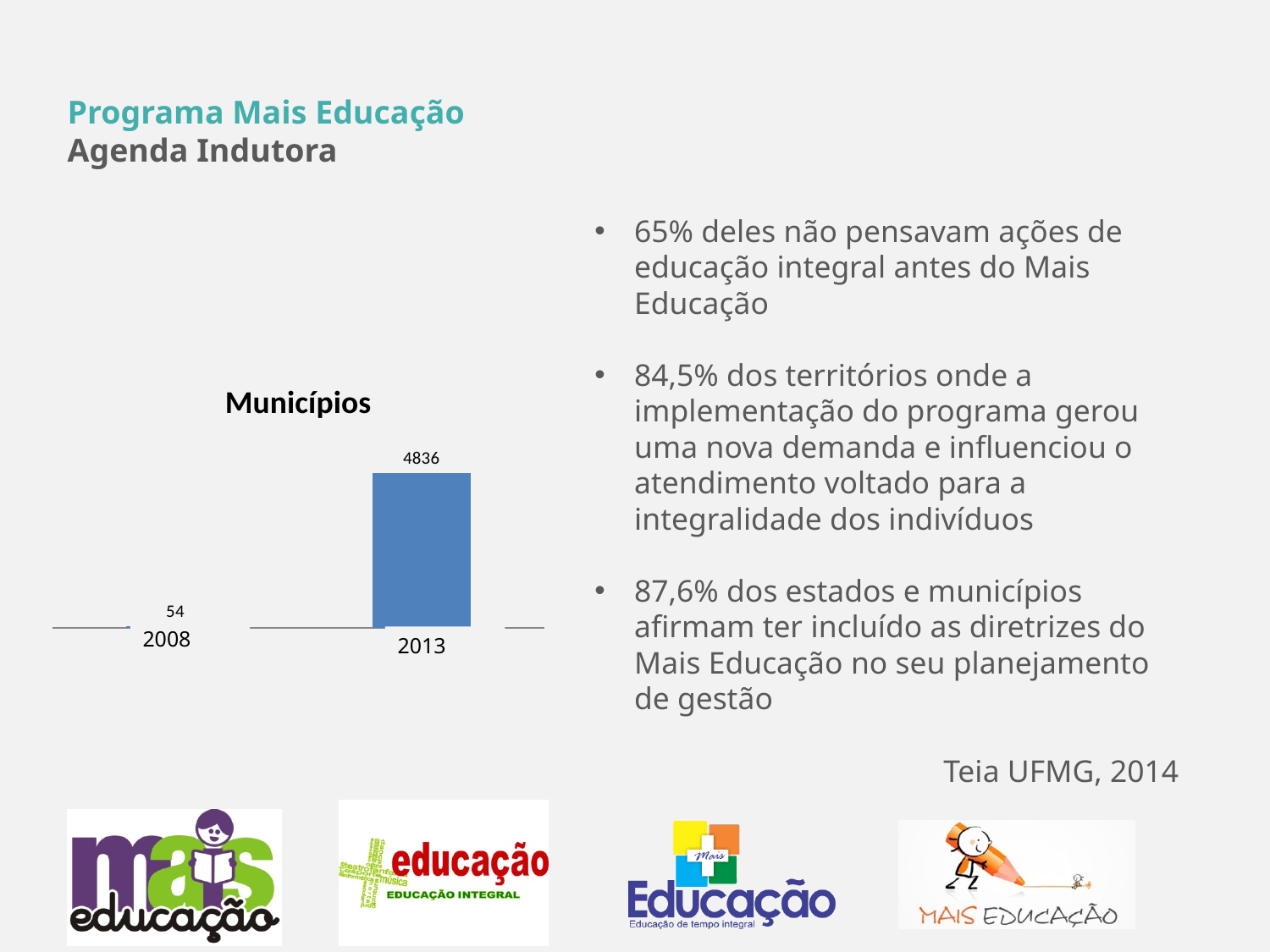
Do the values in the Municípios chart rise or fall from 2008 to 2013? rise What is the value for 2008 in the Municípios chart? 54 Which is larger in the Municípios chart, the value for 2008 or the value for 2013? 2013 What is the value for 2013 in the Municípios chart? 4836 What is the title of the chart on the slide? Municípios How many categories are shown in the Municípios chart? 2 Which year has the highest value in the Municípios chart? 2013 Which year has the lowest value in the Municípios chart? 2008 What is the difference between the 2013 and 2008 values in the Municípios chart? 4782 What kind of chart is the Municípios chart? bar chart What colour are the bars in the Municípios chart? blue